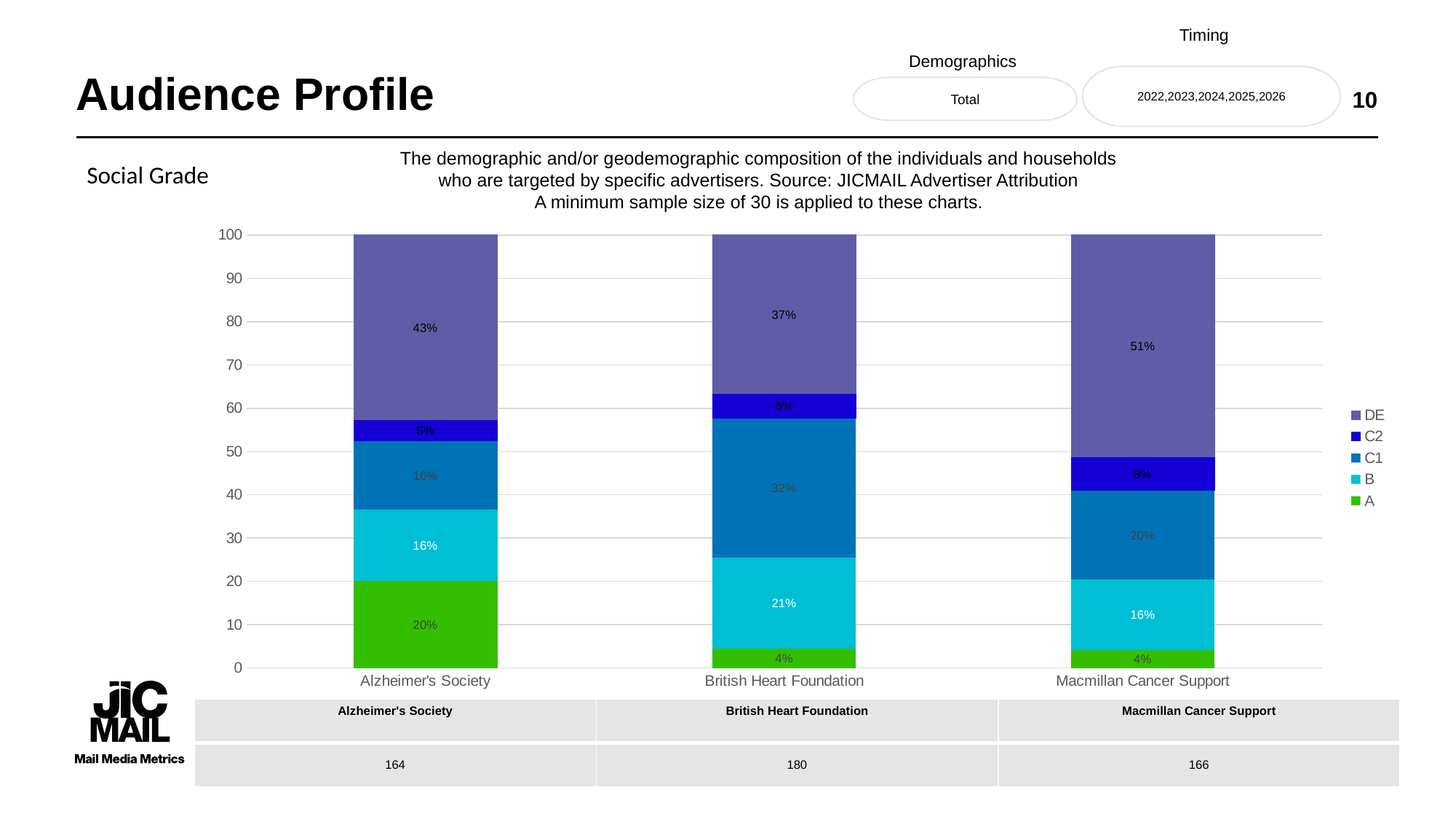
What is the C1 share for British Heart Foundation? 32% What is the A share for Alzheimer's Society? 20% Which is larger: the B share for British Heart Foundation or the B share for Alzheimer's Society? British Heart Foundation How many advertisers are shown on the x axis? 3 Which advertiser has the lowest C2 share? Alzheimer's Society What number is shown in the table below the chart for British Heart Foundation? 180 What is the C2 share for Macmillan Cancer Support? 8% What is the DE share for Macmillan Cancer Support? 51% Which advertiser has the highest DE share? Macmillan Cancer Support How many series does the legend list? 5 What is the difference between the DE share for Macmillan Cancer Support and the DE share for British Heart Foundation? 14% What kind of chart is shown on the slide? Stacked bar chart